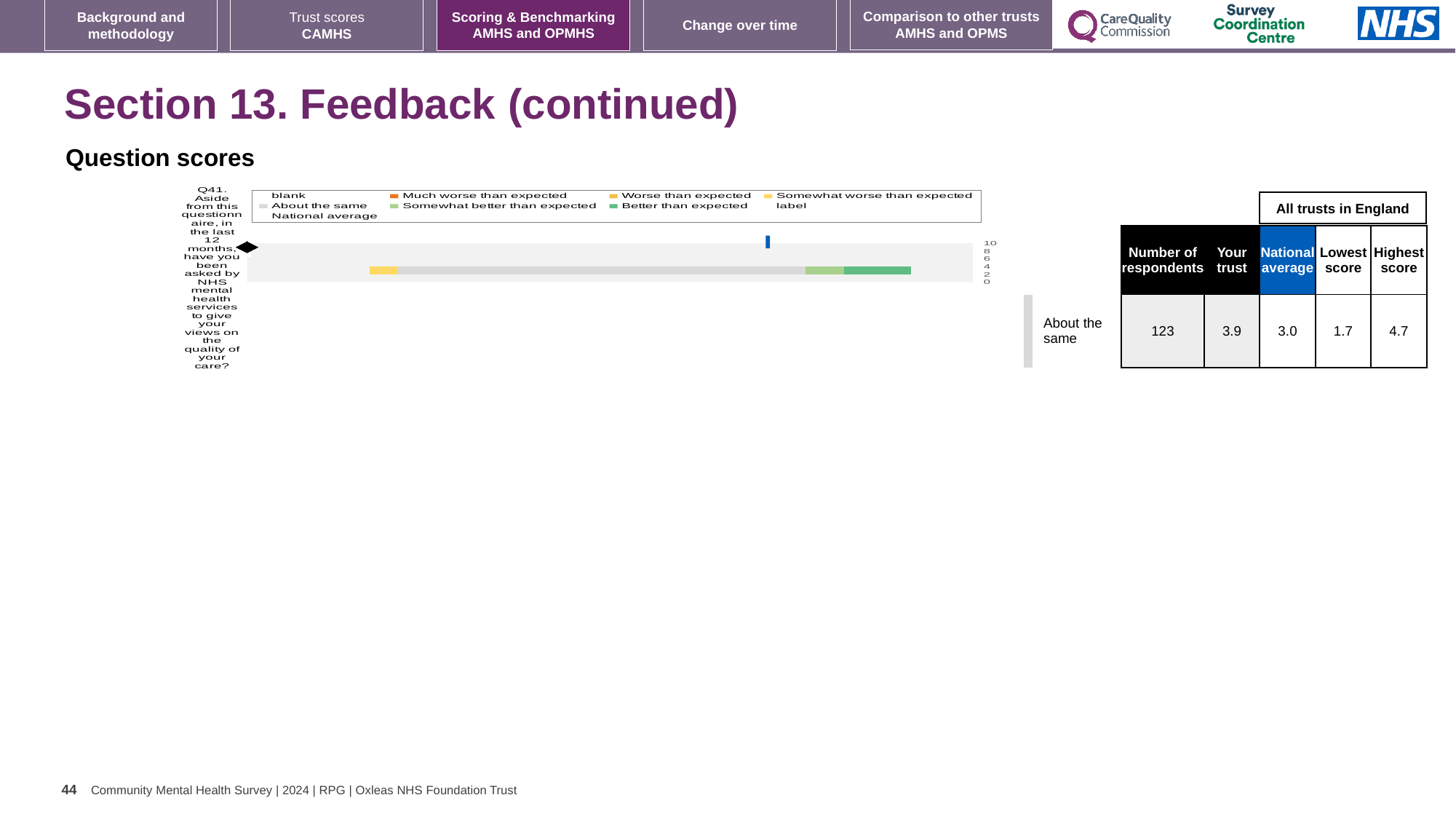
What colour represents 'Better than expected' in the chart legend? green What benchmark category is Q41 assigned to on the slide? About the same Which question number is plotted in the question scores chart? Q41 For Q41, what is the difference between the highest score (4.7) and the lowest score (1.7) across all trusts in England? 3.0 For Q41, which is larger: the trust's score or the national average? Your trust According to the table beside the chart, how many respondents answered Q41? 123 How many questions are plotted in the question scores chart? 1 What type of chart is used to show the Q41 question score? bar chart According to the table beside the chart, what is the trust's score for Q41? 3.9 How many entries does the legend of the question scores chart list? 9 According to the table beside the chart, what is the national average score for Q41? 3.0